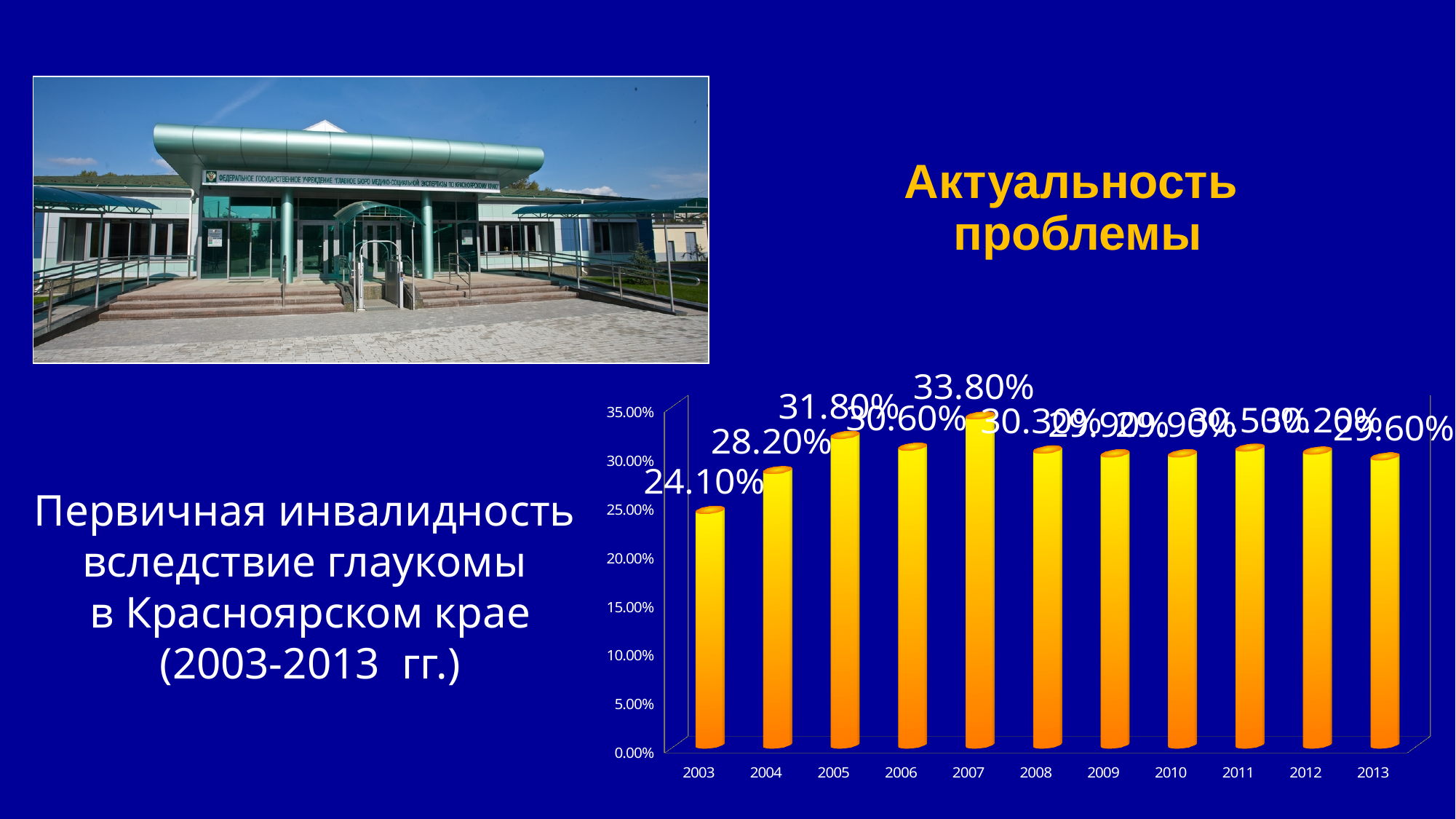
How many years are shown on the x axis? 11 Which year has the lowest value? 2003 Which year has the highest value? 2007 What is the value for 2003? 24.10% What is the difference between the values for 2007 and 2003? 9.70% What is the value for 2013? 29.60% What kind of chart is shown on the slide? bar chart Which is larger, the value for 2005 or the value for 2006? 2005 What is the value for 2007? 33.80% Do the values rise or fall from 2003 to 2005? rise Is the value for 2003 greater or less than 25.00%? less What is the value for 2005? 31.80%